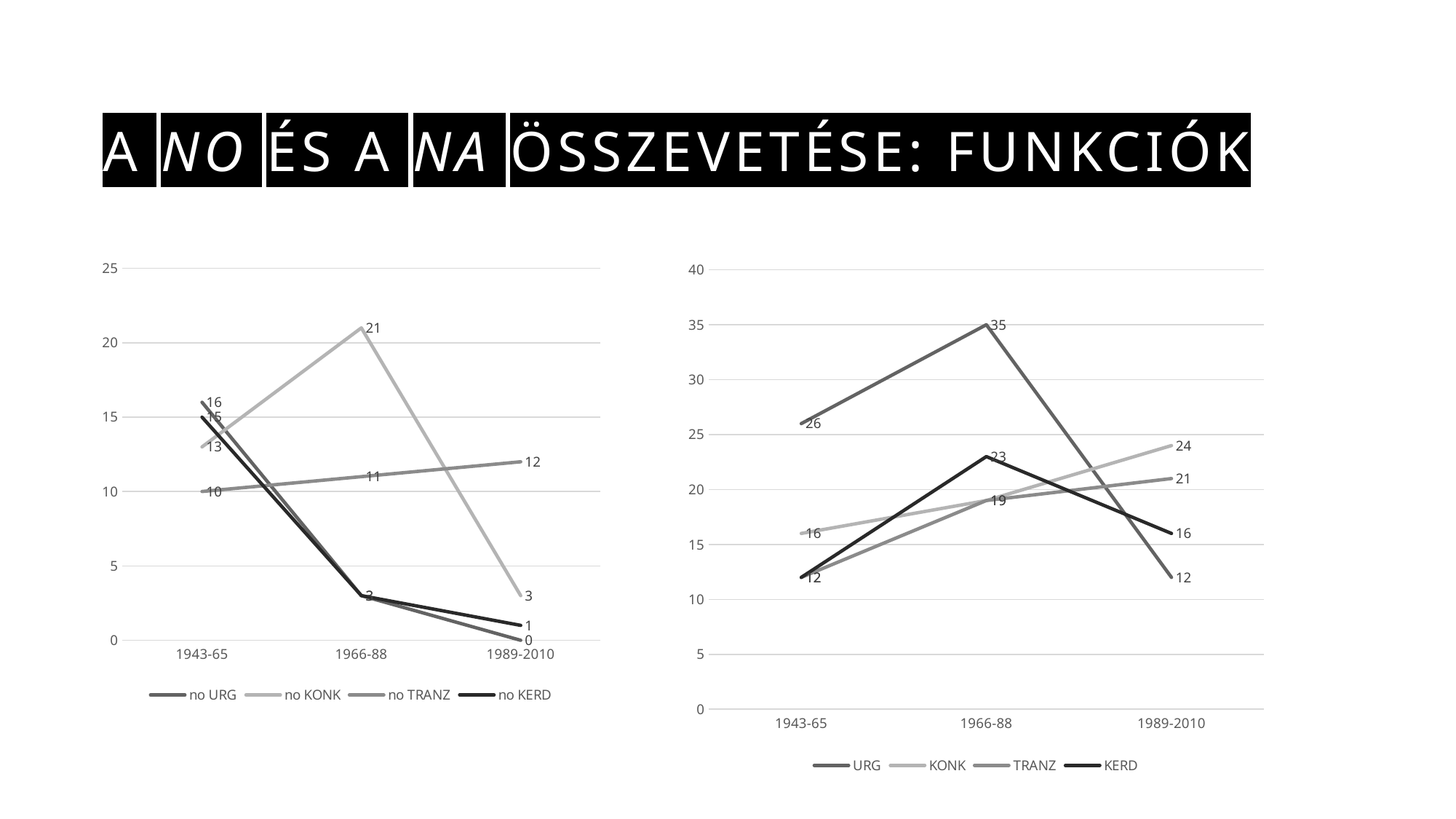
In the right chart, does the KONK series rise or fall from 1943-65 to 1989-2010? rise In the right chart, what is the value of KONK for 1989-2010? 24 In the right chart, what is the value of URG for 1966-88? 35 In the right chart, which series has the highest value for 1943-65? URG In the left chart, which series has the lowest value for 1989-2010? no URG In the left chart, which is larger for 1966-88: no KONK or no TRANZ? no KONK What kind of chart is the left chart? line chart In the left chart, what is the value of no KONK for 1966-88? 21 In the left chart, what is the value of no TRANZ for 1989-2010? 12 How many series does the legend of the right chart list? 4 In the right chart, what is the difference between the URG values for 1966-88 and 1989-2010? 23 How many categories are shown on the x axis of the left chart? 3